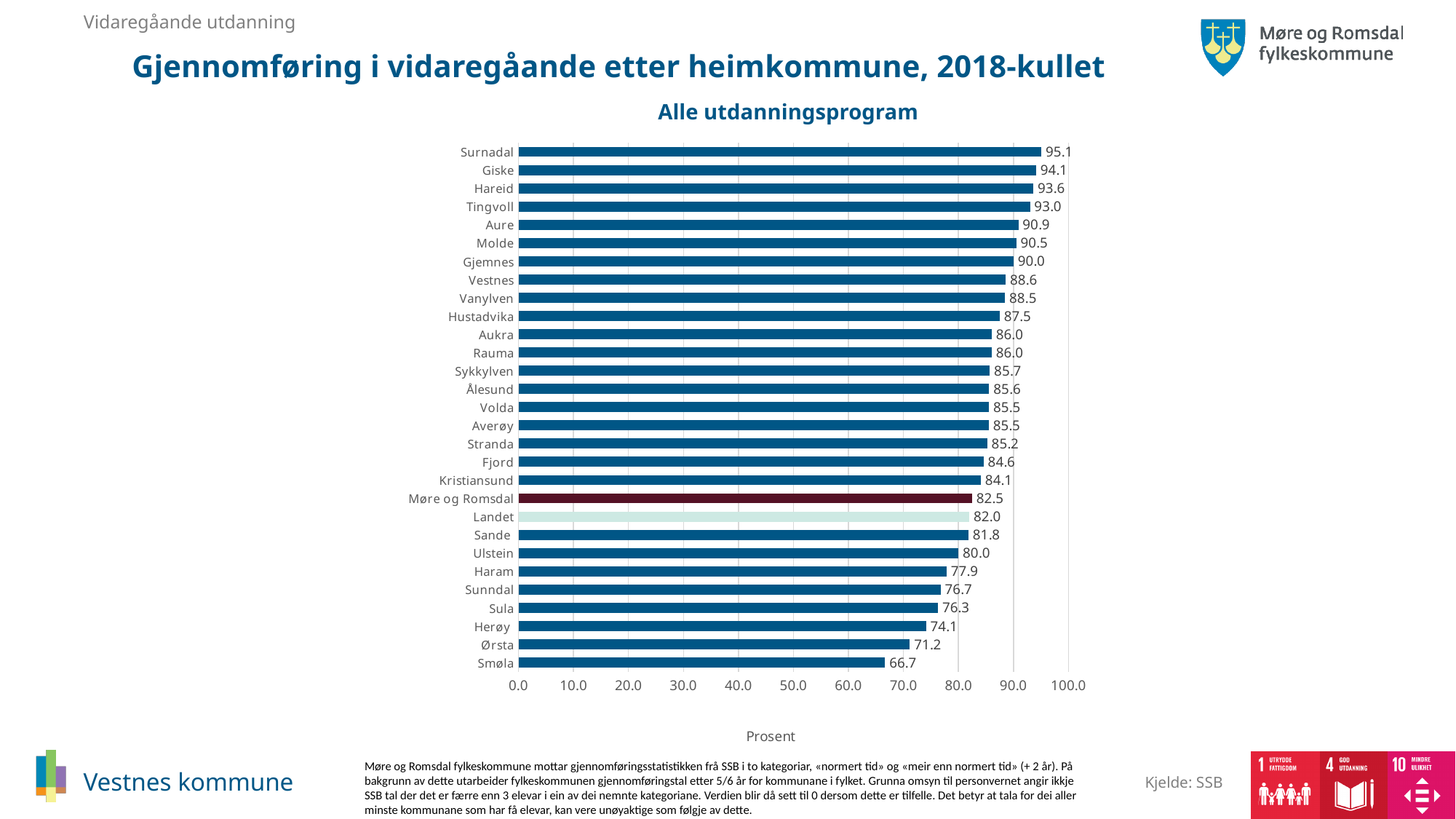
What is the title of the chart? Alle utdanningsprogram What is the value for Landet? 82.0 What is the difference between the values for Vestnes and Landet? 6.6 What is the value for Vestnes? 88.6 Which is larger, the value for Molde or the value for Ålesund? Molde How many categories are shown on the chart? 29 What is the difference between the values for Surnadal and Smøla? 28.4 Which category has the lowest value? Smøla Which category has the highest value? Surnadal What kind of chart is shown on the slide? bar chart Is the value for Ørsta greater or less than 80.0? less What is the value for Møre og Romsdal? 82.5